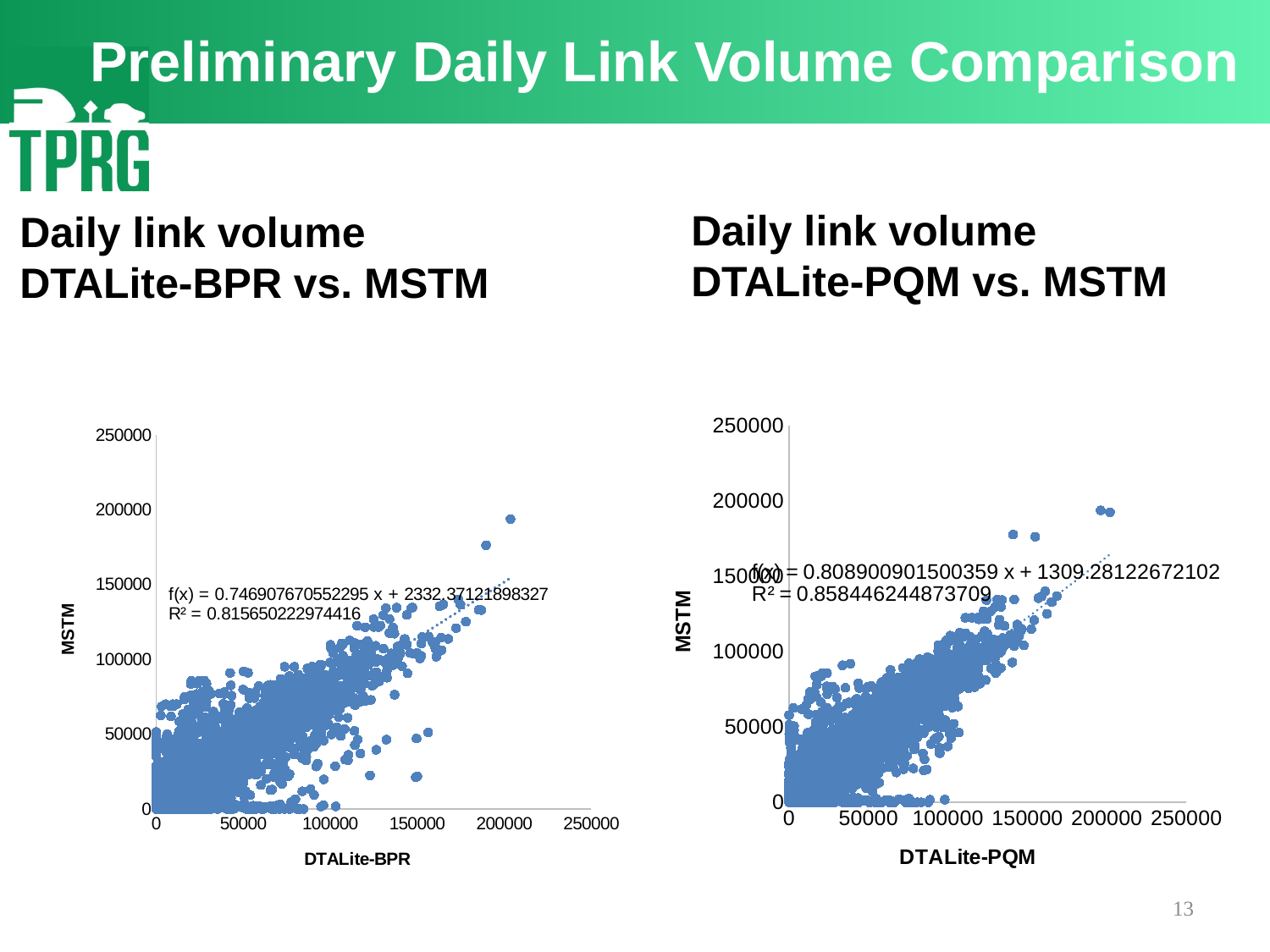
What kind of chart is the 'Daily link volume DTALite-PQM vs. MSTM' chart on the right? Scatter chart In the left chart (DTALite-BPR vs. MSTM), what is the trendline equation shown? f(x) = 0.746907670552295 x + 2332.37121898327 What is the difference between the R² values of the right chart (DTALite-PQM) and the left chart (DTALite-BPR)? 0.042796021899293 In the right chart (DTALite-PQM vs. MSTM), what is the R² value shown for the trendline? 0.858446244873709 In the right chart (DTALite-PQM vs. MSTM), do the MSTM values generally rise or fall as DTALite-PQM increases? Rise What is the label on the y axis of the right chart? MSTM What is the label on the x axis of the left chart? DTALite-BPR In the left chart (DTALite-BPR vs. MSTM), do the MSTM values generally rise or fall as DTALite-BPR increases? Rise In the left chart (DTALite-BPR vs. MSTM), what is the R² value shown for the trendline? 0.815650222974416 Which chart has the higher R² value, the DTALite-BPR vs. MSTM chart or the DTALite-PQM vs. MSTM chart? DTALite-PQM vs. MSTM In the right chart (DTALite-PQM vs. MSTM), what is the trendline equation shown? f(x) = 0.808900901500359 x + 1309.28122672102 What kind of chart is the 'Daily link volume DTALite-BPR vs. MSTM' chart on the left? Scatter chart